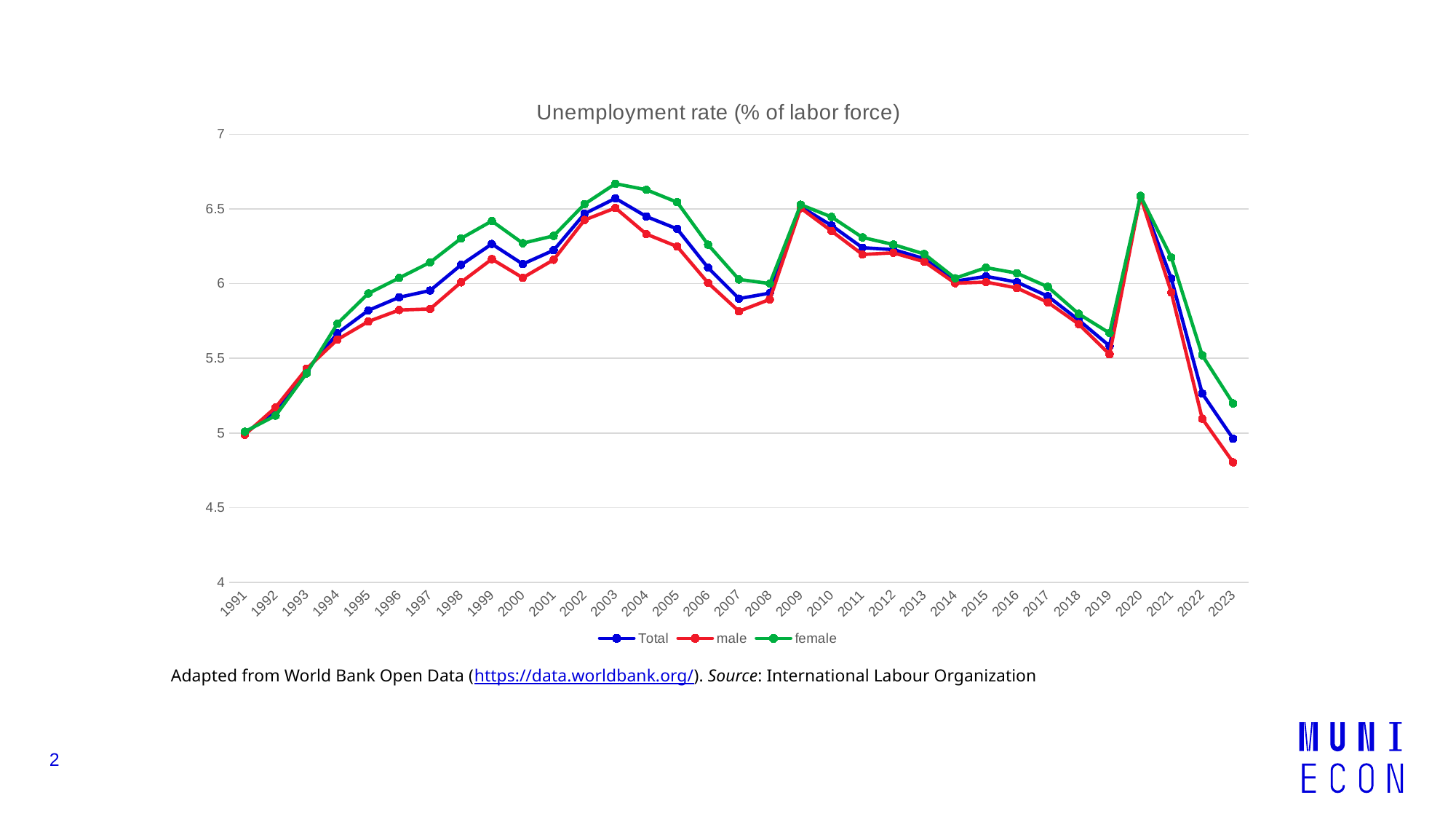
Do the values for Total rise or fall from 2020 to 2023? fall Is the value for Total in 2007 greater or less than 6? less Is the value for male in 2022 greater or less than 5.5? less What kind of chart is shown on the slide? line chart What is the title of the chart? Unemployment rate (% of labor force) Which series has the highest value in 2021? female In 2023, is the value for female or for male larger? female Is the value for male in 2023 greater or less than 5? less How many years are plotted along the x axis? 33 How many series does the legend list? 3 Which series has the lowest value in 2023? male